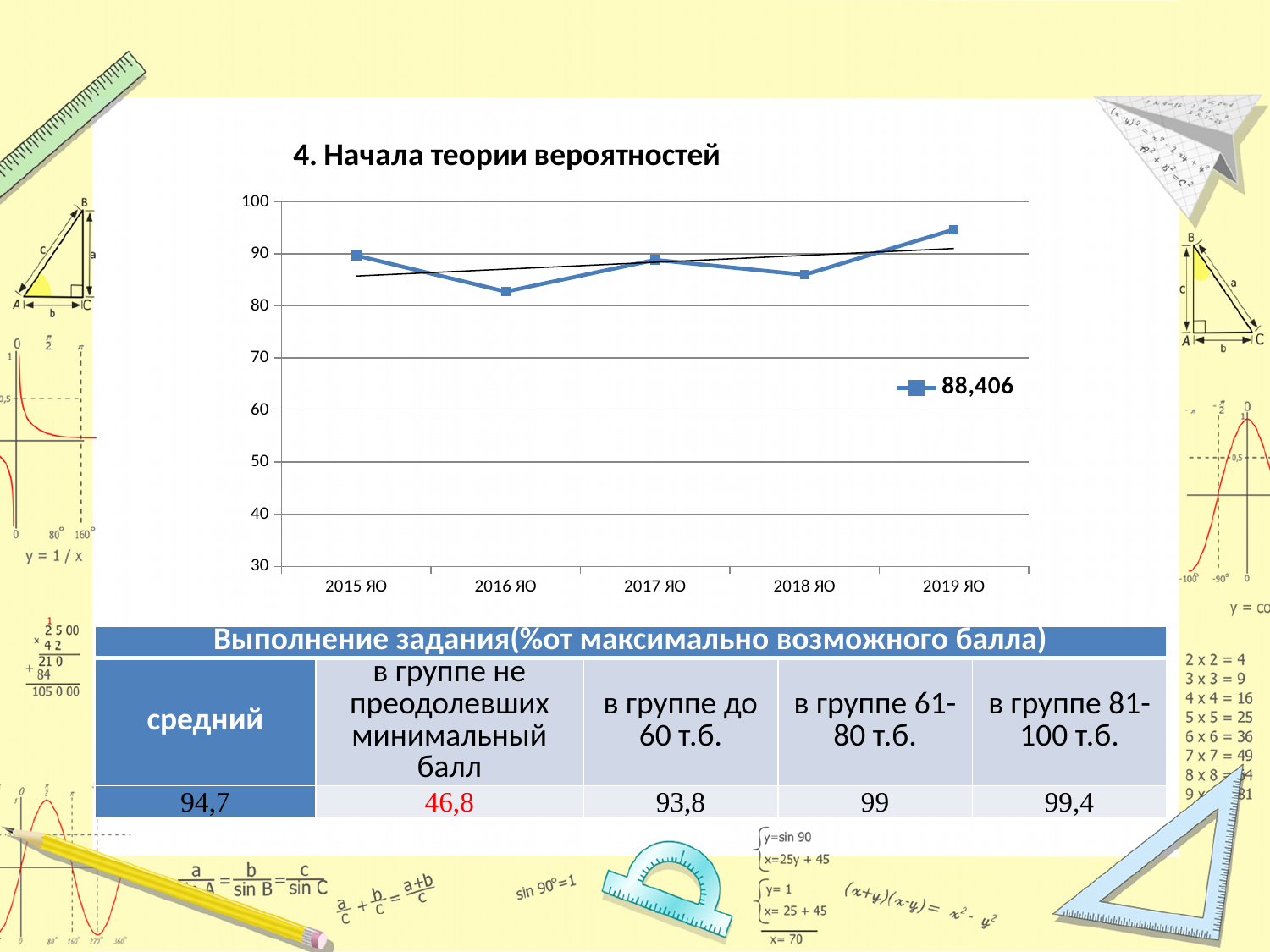
What kind of chart is shown on the slide? line chart Which is larger, the value for 2019 ЯО or the value for 2016 ЯО? 2019 ЯО Is the value for 2019 ЯО greater or less than 90? greater Which year has the lowest value on the chart? 2016 ЯО Which is larger, the value for 2018 ЯО or the value for 2016 ЯО? 2018 ЯО Is the value for 2018 ЯО greater or less than 90? less How many data points (years) are plotted along the x axis of the chart? 5 What is the title of the chart? 4. Начала теории вероятностей What label appears in the chart legend? 88,406 Which year has the highest value on the chart? 2019 ЯО How many series does the chart legend list? 1 Is the value for 2016 ЯО greater or less than 90? less